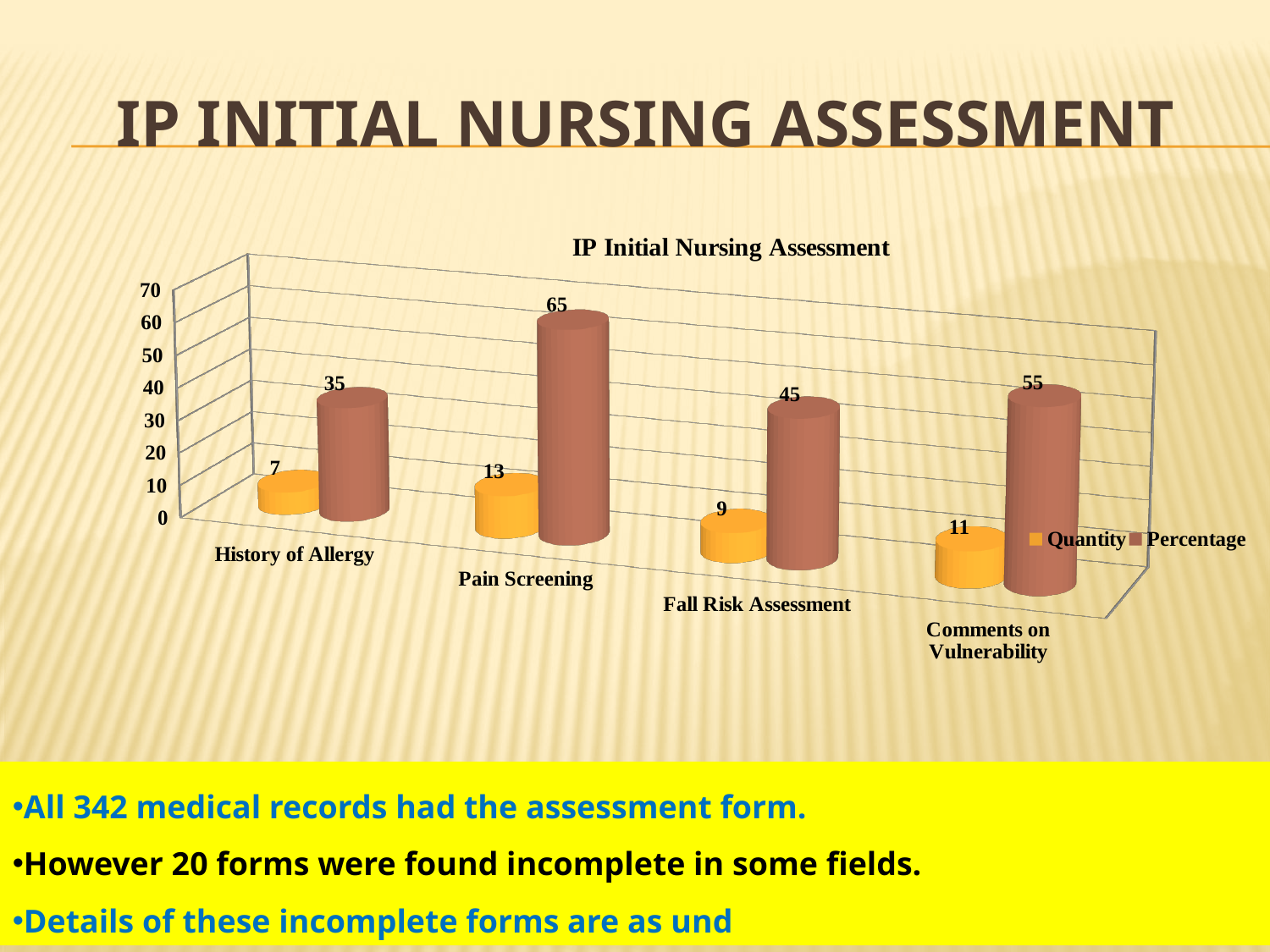
What is the Percentage value for Comments on Vulnerability? 55 Which category has the lowest Quantity value? History of Allergy What kind of chart is shown on the slide? Bar chart Which series is shown in orange in the legend? Quantity Which category has the highest Percentage value? Pain Screening How many categories are shown on the x axis? 4 What is the difference between the Percentage values for Pain Screening and Fall Risk Assessment? 20 How many series does the legend list? 2 What is the Quantity value for Pain Screening? 13 What is the title of the chart? IP Initial Nursing Assessment What is the Quantity value for History of Allergy? 7 Which is larger, the Quantity for Fall Risk Assessment or the Quantity for Comments on Vulnerability? Comments on Vulnerability